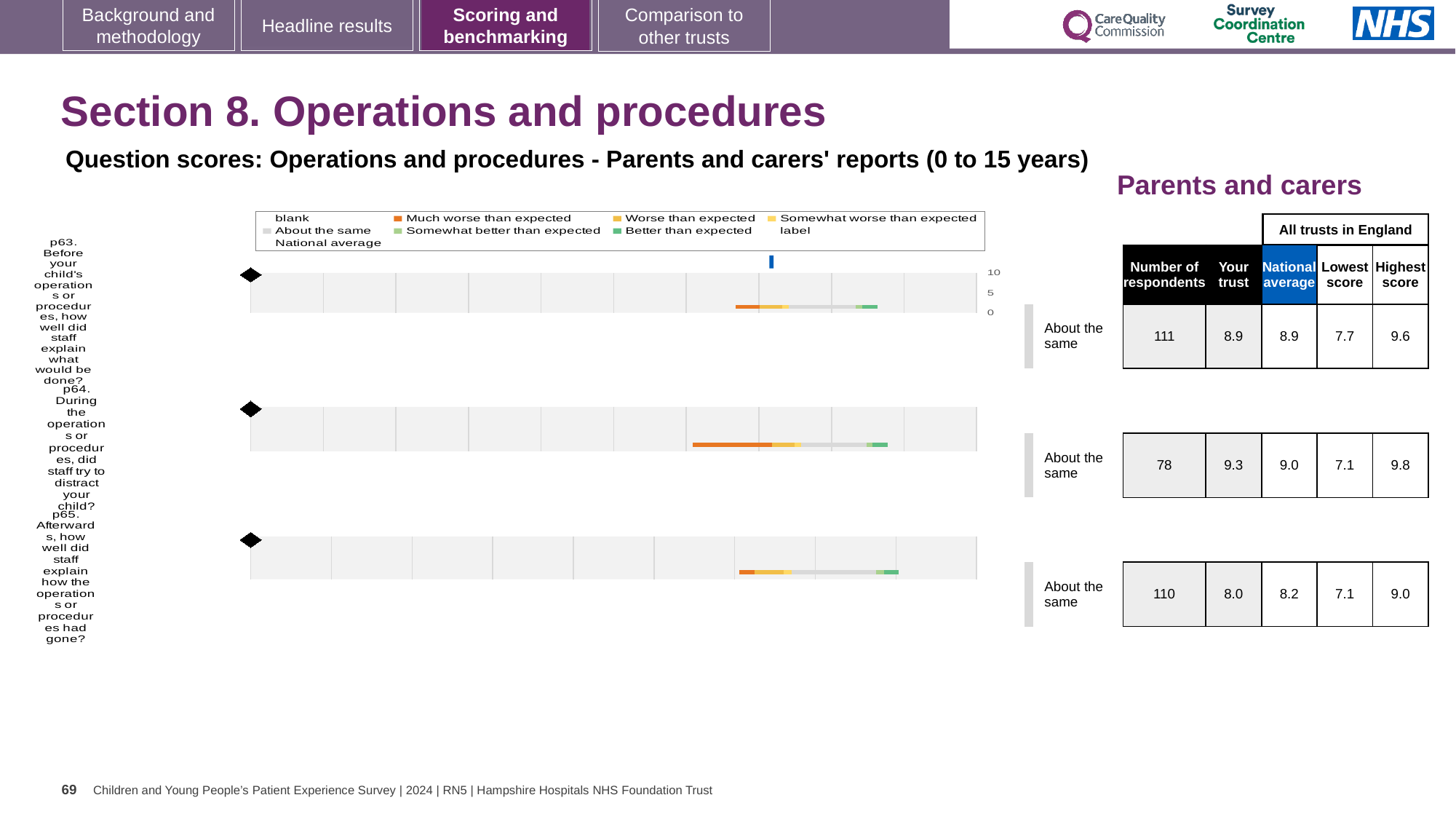
Which question has the lowest 'Your trust' score? p65 What is the national average score for p63 (Before your child's operations or procedures, how well did staff explain what would be done?)? 8.9 How many questions (p63, p64, p65) are plotted on the slide? 3 What is the difference between the 'Your trust' score and the national average for p63? 0.0 For p64, what is the difference between the highest score and the lowest score across all trusts in England? 2.7 For p65, which is larger: the 'Your trust' score or the national average? National average What benchmark category is shown for p63? About the same What kind of chart is used to show the question scores on this slide? Bar chart Which question has the highest 'Your trust' score? p64 What is the 'Your trust' score for p64 (During the operations or procedures, did staff try to distract your child?)? 9.3 How many respondents answered p65 (Afterwards, how well did staff explain how the operations or procedures had gone?)? 110 How many entries does the chart legend list? 9